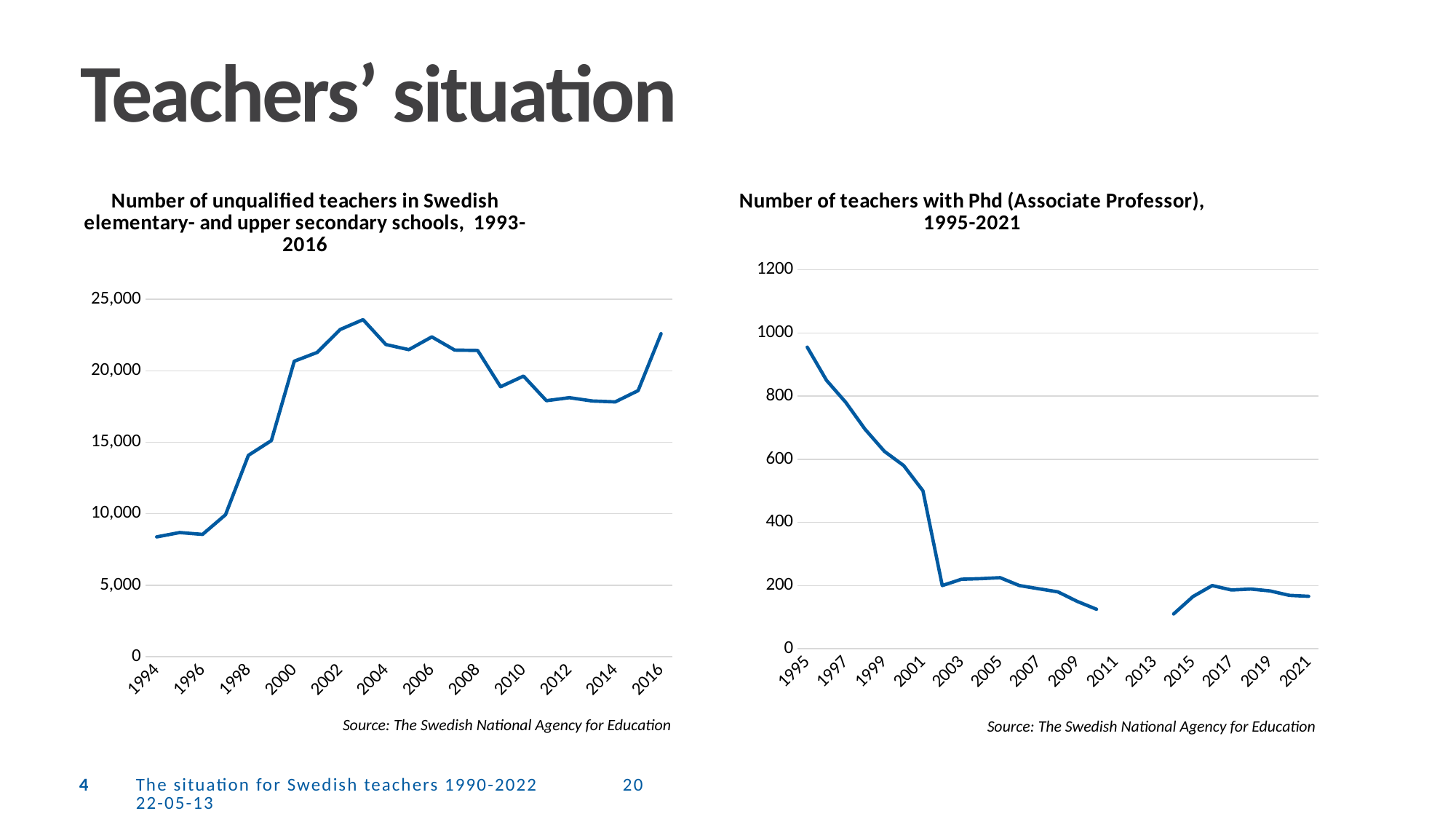
What kind of chart is the right chart, 'Number of teachers with Phd (Associate Professor), 1995-2021'? line chart In the left chart on unqualified teachers, is the value for 1994 greater or less than 10,000? less In the left chart on unqualified teachers, is the value for 2000 greater or less than 20,000? greater In the right chart on teachers with Phd, do the values generally rise or fall from 1995 to 2021? fall What kind of chart is the left chart, 'Number of unqualified teachers in Swedish elementary- and upper secondary schools, 1993-2016'? line chart What source is cited below both charts? The Swedish National Agency for Education In the left chart on unqualified teachers, is the value for 2003 larger or smaller than the value for 2012? larger In the right chart on teachers with Phd, which year has the highest value? 1995 In the left chart on unqualified teachers, which year has the highest value? 2003 In the right chart on teachers with Phd, is the value for 2015 greater or less than 200? less